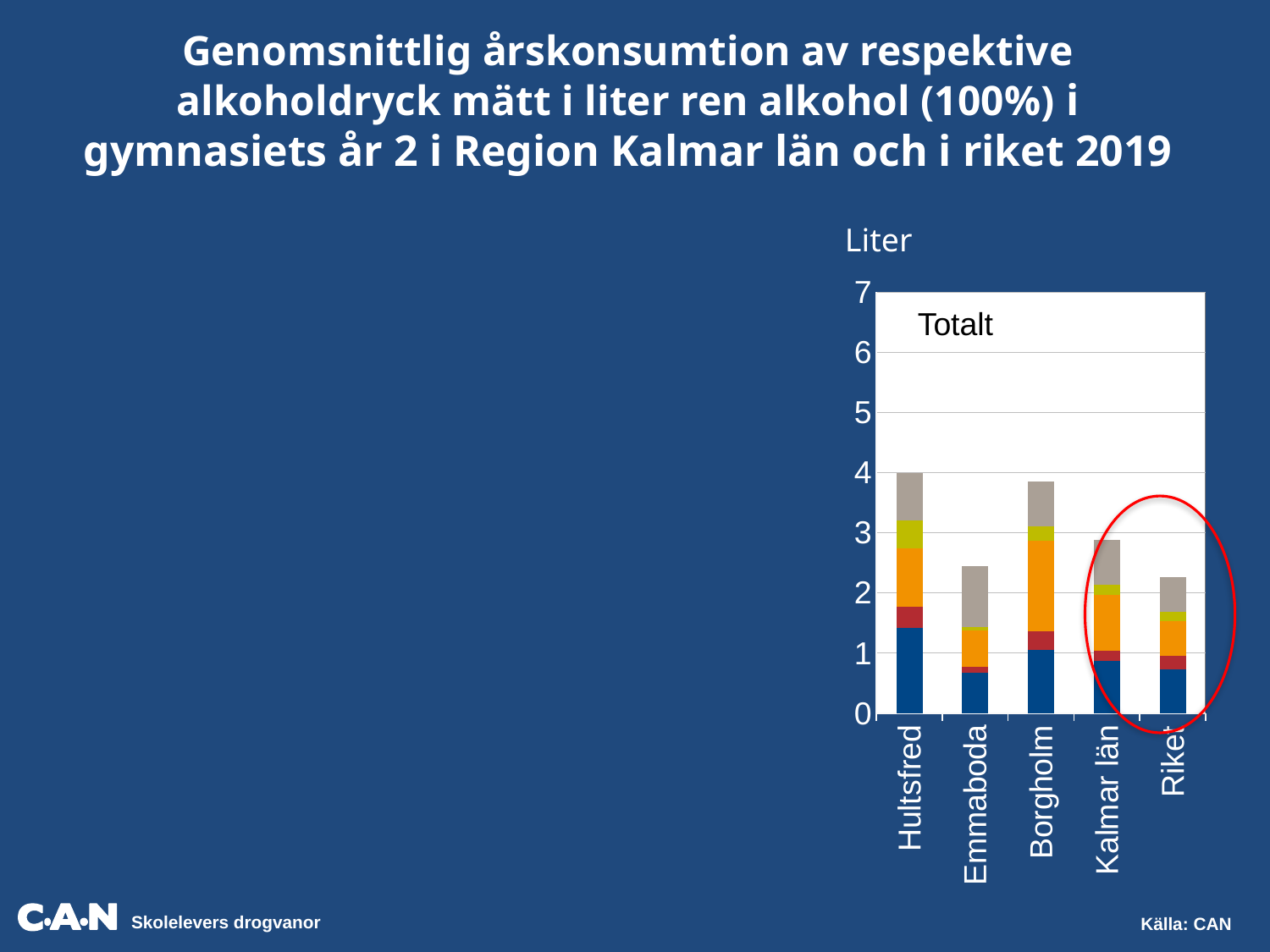
Which has a higher total bar, Hultsfred or Riket? Hultsfred Which has a higher total bar, Borgholm or Kalmar län? Borgholm What kind of chart is shown on the slide? Stacked bar chart Which has a higher total bar, Hultsfred or Emmaboda? Hultsfred What unit label is shown above the y axis of the chart? Liter Is the total value for Emmaboda greater or less than 3? less Is the total value for Hultsfred greater or less than 3? greater Is the total value for Borgholm greater or less than 3? greater How many categories are shown on the x axis of the chart? 5 What is the title shown inside the chart area? Totalt